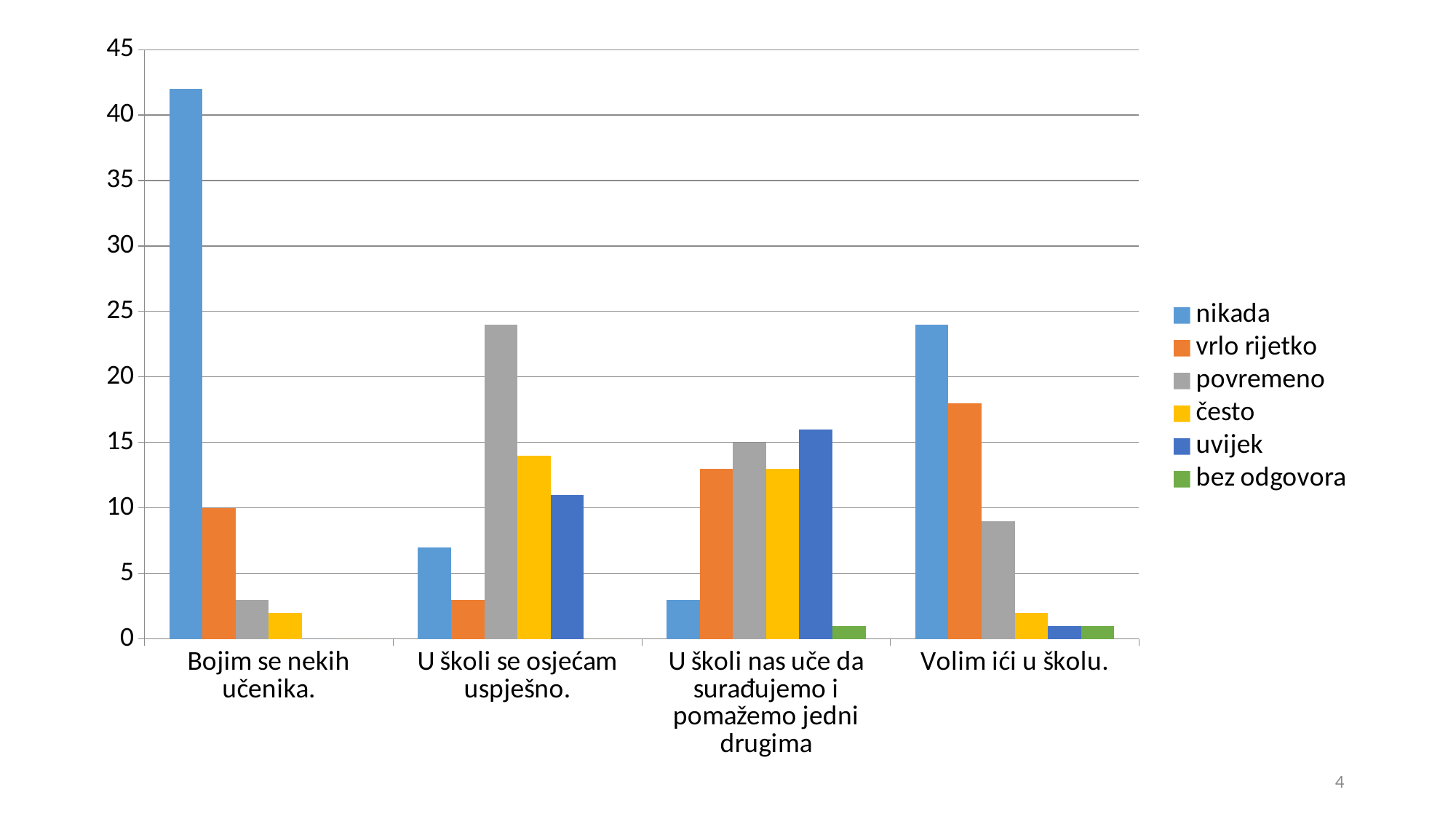
What kind of chart is shown on the slide? bar chart How many series does the legend list? 6 Which series has the tallest bar in the whole chart? nikada For "Volim ići u školu.", which is larger: the value for "nikada" or the value for "vrlo rijetko"? nikada Is the value of "nikada" for "Bojim se nekih učenika." greater or less than 40? greater Which colour represents the series "često" in the legend? yellow How many categories are shown on the x axis? 4 Is the value of "povremeno" for "U školi se osjećam uspješno." greater or less than 20? greater For the category "Bojim se nekih učenika.", which series has the highest value? nikada Is the value of "uvijek" for "U školi nas uče da surađujemo i pomažemo jedni drugima" greater or less than 10? greater For the category "U školi se osjećam uspješno.", which series has the highest value? povremeno